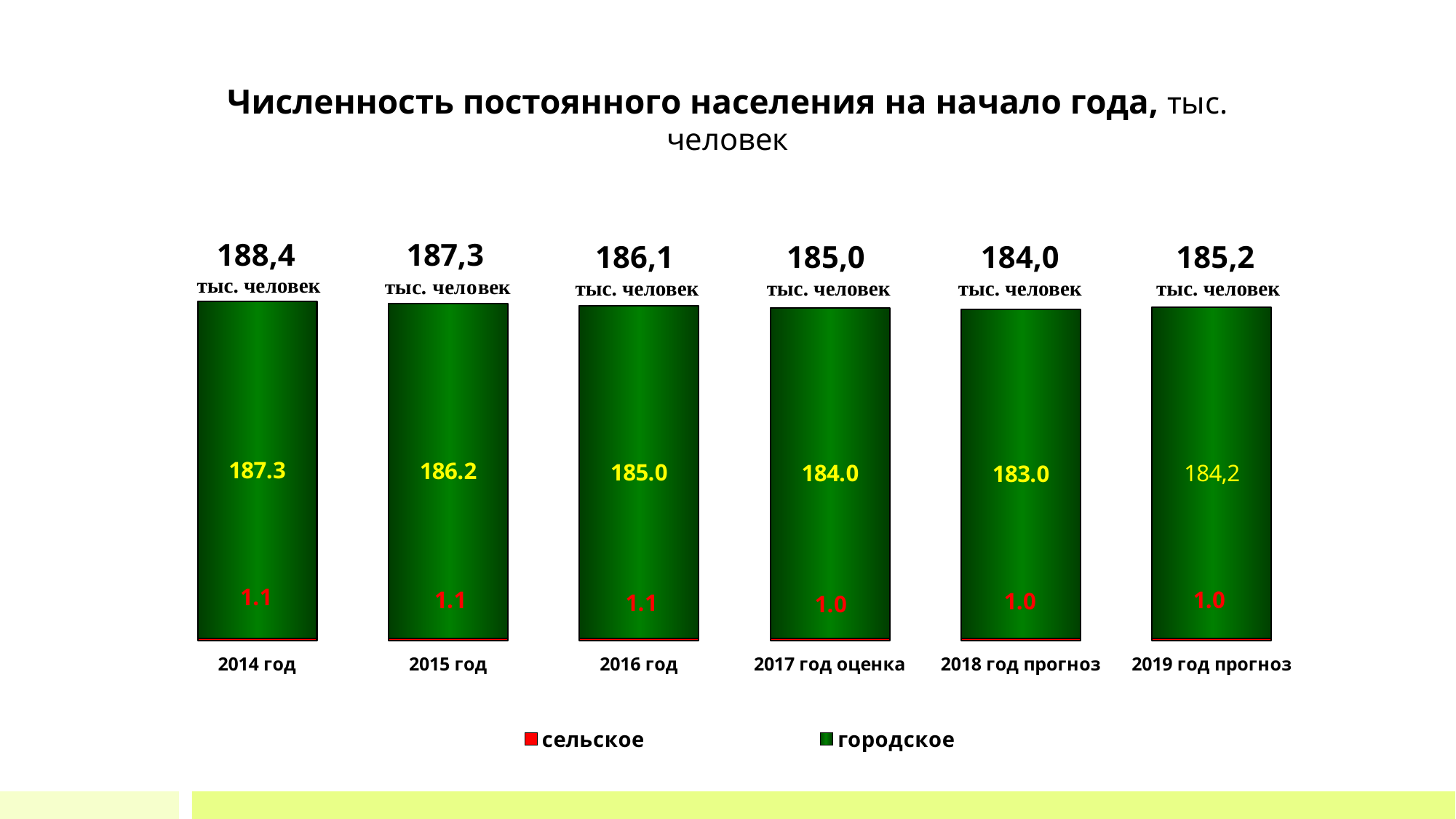
Which year has the lowest value for городское? 2018 год прогноз How many years are shown on the x axis? 6 Which year has the highest value for городское? 2014 год What is the value for городское in 2019 год прогноз? 184,2 What is the total of the stacked bar for 2014 год? 188,4 Which is larger, the городское value for 2015 год or for 2016 год? 2015 год What kind of chart is shown on the slide? Stacked bar chart What is the value for городское in 2014 год? 187.3 Do the городское values rise or fall from 2014 год to 2018 год прогноз? Fall What is the value for сельское in 2017 год оценка? 1.0 What is the difference between the городское values for 2014 год and 2018 год прогноз? 4.3 How many series does the legend list? 2